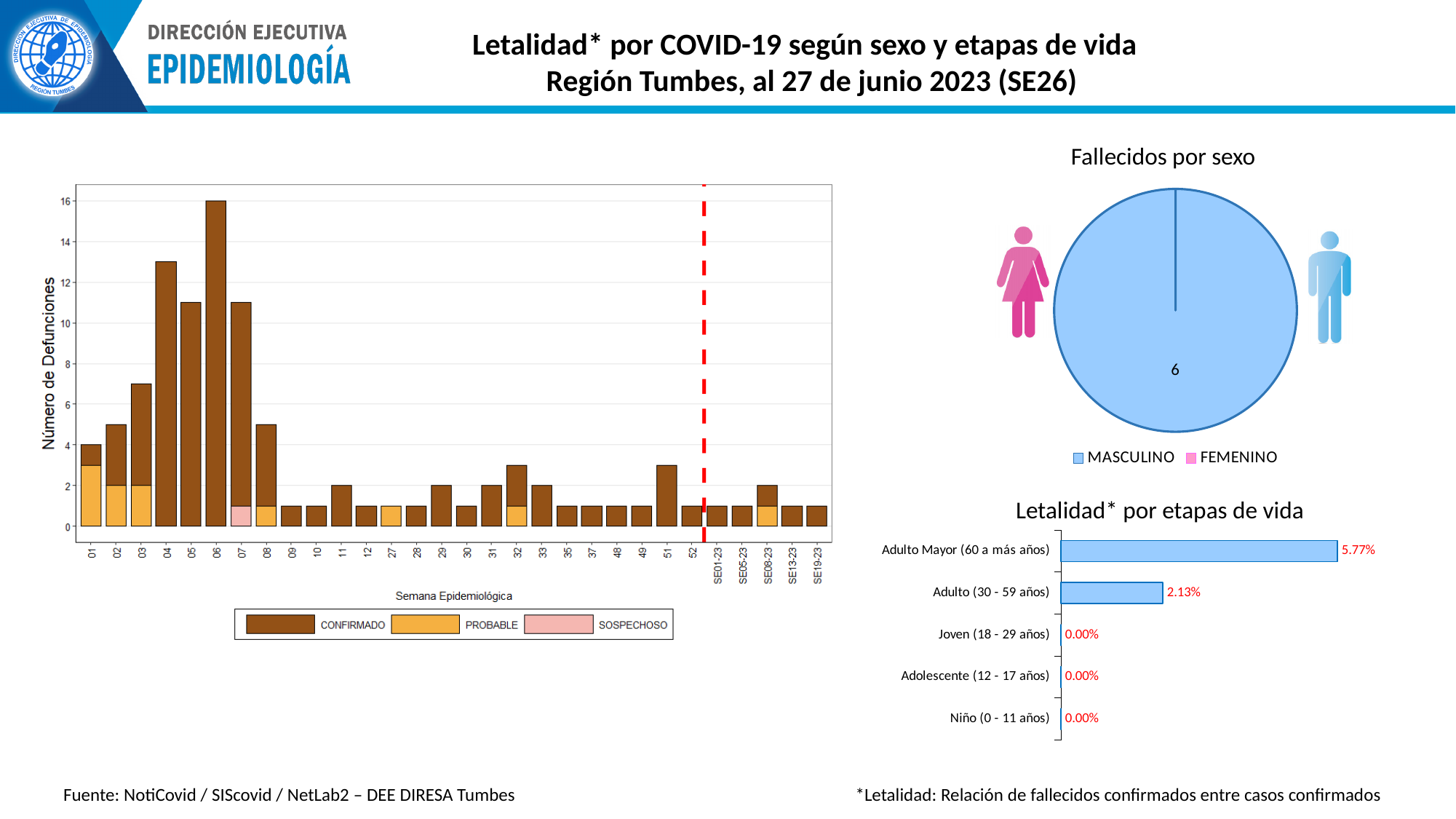
In the bar chart on the left (Número de Defunciones by Semana Epidemiológica), what is the total number of deaths in week 06? 16 In the 'Letalidad* por etapas de vida' chart, how many age groups are shown? 5 In the 'Fallecidos por sexo' pie chart, how many entries does the legend list? 2 In the 'Letalidad* por etapas de vida' chart, which age group has the highest value? Adulto Mayor (60 a más años) In the 'Letalidad* por etapas de vida' chart, what is the value for Adulto (30 - 59 años)? 2.13% In the 'Fallecidos por sexo' pie chart, what value is shown for MASCULINO? 6 In the 'Letalidad* por etapas de vida' chart, what is the difference between the values for Adulto Mayor (60 a más años) and Adulto (30 - 59 años)? 3.64% In the bar chart on the left (Número de Defunciones by Semana Epidemiológica), which week has the highest number of deaths? 06 In the bar chart on the left (Número de Defunciones by Semana Epidemiológica), is the value for week 04 greater or less than 12? greater In the bar chart on the left (Número de Defunciones by Semana Epidemiológica), how many series does the legend list? 3 In the 'Letalidad* por etapas de vida' chart, what is the value for Adulto Mayor (60 a más años)? 5.77% In the 'Letalidad* por etapas de vida' chart, what is the value for Joven (18 - 29 años)? 0.00%